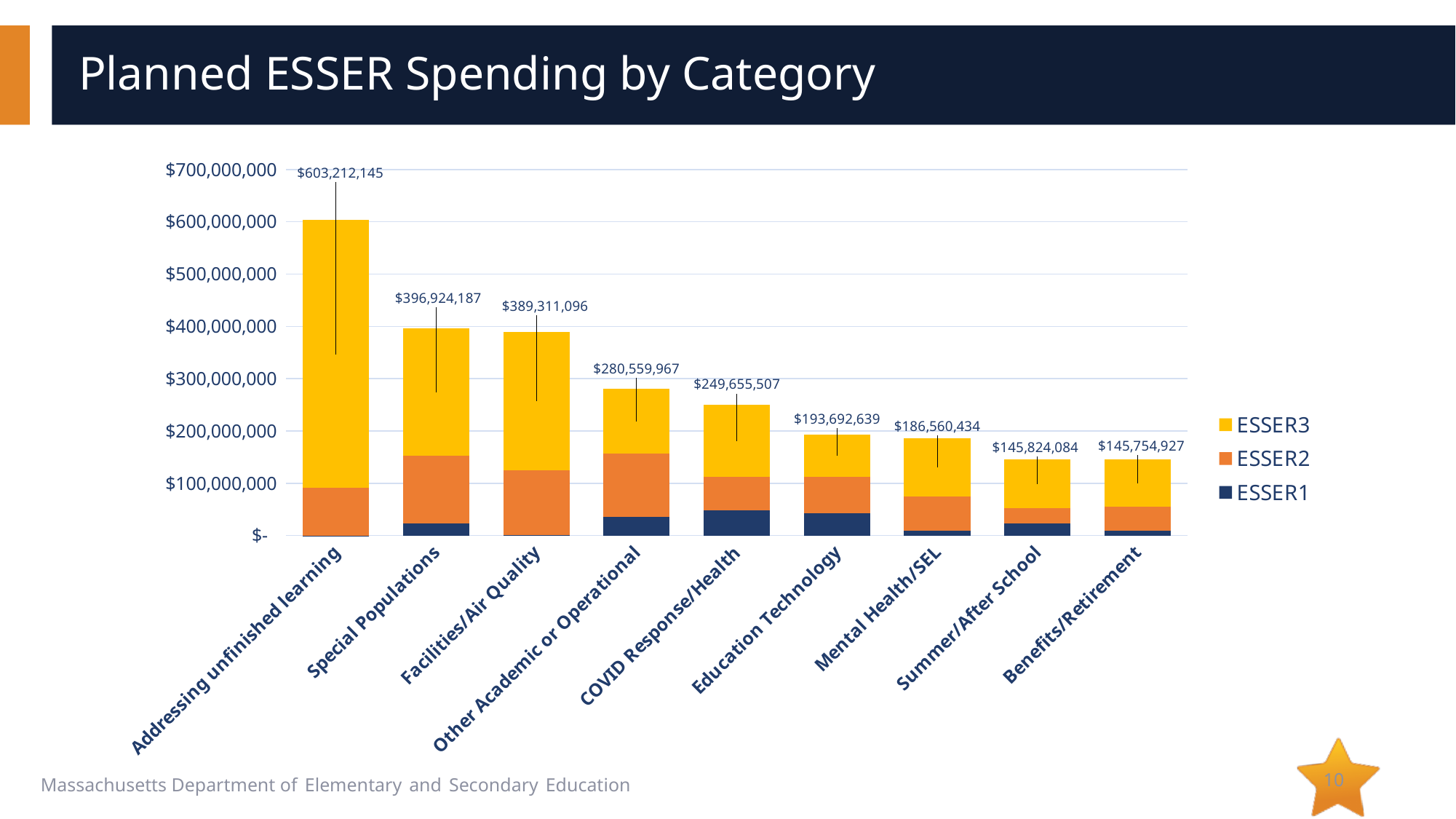
What is the total planned spending for COVID Response/Health? $249,655,507 What kind of chart is shown on the slide? stacked bar chart Which category has the highest total planned spending? Addressing unfinished learning What is the total planned spending for Special Populations? $396,924,187 Which has a larger total, Special Populations or Facilities/Air Quality? Special Populations How many series does the legend list? 3 How many spending categories are shown on the x axis? 9 Is the ESSER1 value for COVID Response/Health greater or less than $100,000,000? less What is the total planned spending for Summer/After School? $145,824,084 What is the difference between the totals for Addressing unfinished learning and Special Populations? $206,287,958 What is the total planned spending for Addressing unfinished learning? $603,212,145 Do the total values rise or fall moving from left to right along the x axis? fall